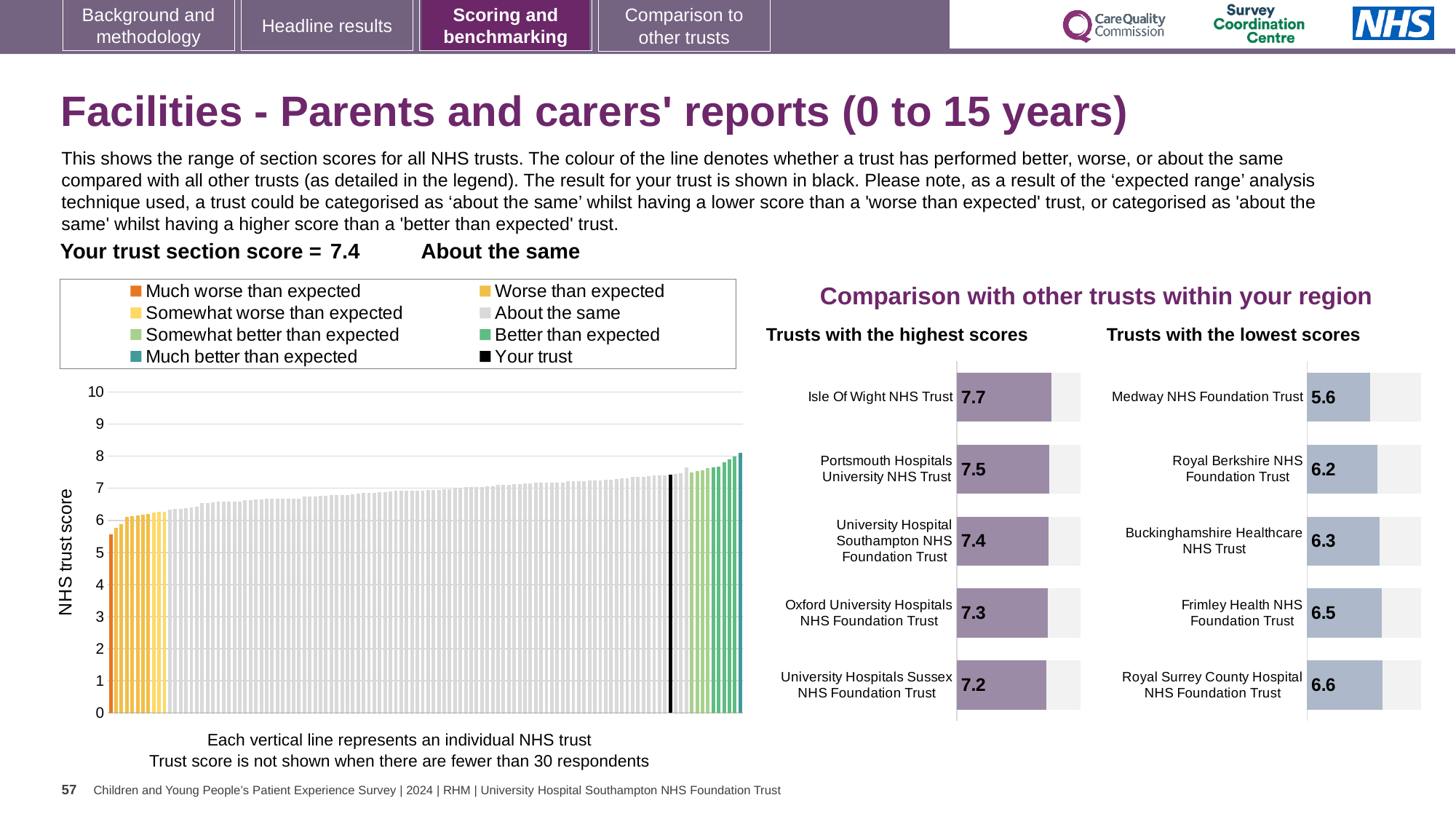
In the 'Trusts with the lowest scores' chart, which has the larger score: Royal Berkshire NHS Foundation Trust or Frimley Health NHS Foundation Trust? Frimley Health NHS Foundation Trust In the 'Trusts with the lowest scores' chart, what is the score for Buckinghamshire Healthcare NHS Trust? 6.3 In the 'Trusts with the highest scores' chart, what is the score for Isle Of Wight NHS Trust? 7.7 In the main chart on the left showing all NHS trusts, what kind of chart is it? Bar chart In the 'Trusts with the lowest scores' chart, what is the score for Medway NHS Foundation Trust? 5.6 In the main chart on the left showing all NHS trusts, how many entries does the legend list? 8 In the 'Trusts with the lowest scores' chart, which trust has the highest score shown? Royal Surrey County Hospital NHS Foundation Trust In the 'Trusts with the highest scores' chart, which trust has the lowest score shown? University Hospitals Sussex NHS Foundation Trust In the main chart on the left showing all NHS trusts, what is the label of the y axis? NHS trust score In the 'Trusts with the highest scores' chart, how many trusts are listed? 5 In the 'Trusts with the highest scores' chart, what is the difference between the scores of Isle Of Wight NHS Trust and University Hospitals Sussex NHS Foundation Trust? 0.5 In the main chart on the left showing all NHS trusts, do the bar values rise or fall from left to right? Rise